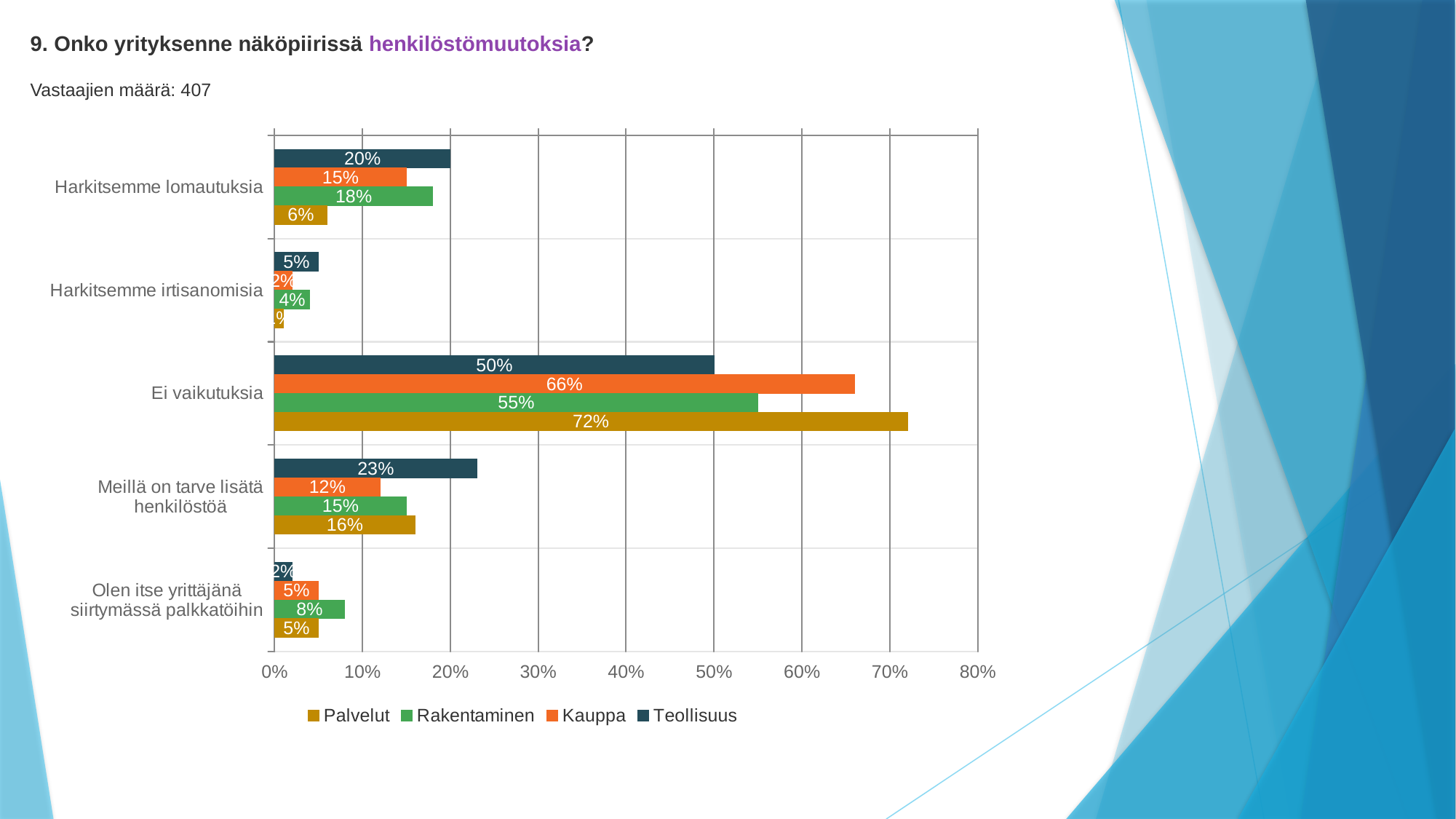
How many categories are shown on the vertical axis of the chart? 5 How many series does the legend list? 4 Which series is shown in green in the legend? Rakentaminen Is the value for Rakentaminen in the 'Ei vaikutuksia' category greater or less than 50%? greater What is the value for Teollisuus in the 'Harkitsemme lomautuksia' category? 20% What is the difference between the Kauppa and Teollisuus values in the 'Ei vaikutuksia' category? 16% What is the value for Kauppa in the 'Meillä on tarve lisätä henkilöstöä' category? 12% In the 'Olen itse yrittäjänä siirtymässä palkkatöihin' category, which is larger: Rakentaminen or Kauppa? Rakentaminen Which series has the highest value in the 'Ei vaikutuksia' category? Palvelut Which series has the lowest value in the 'Harkitsemme lomautuksia' category? Palvelut What is the value for Palvelut in the 'Ei vaikutuksia' category? 72% What kind of chart is shown on the slide? bar chart